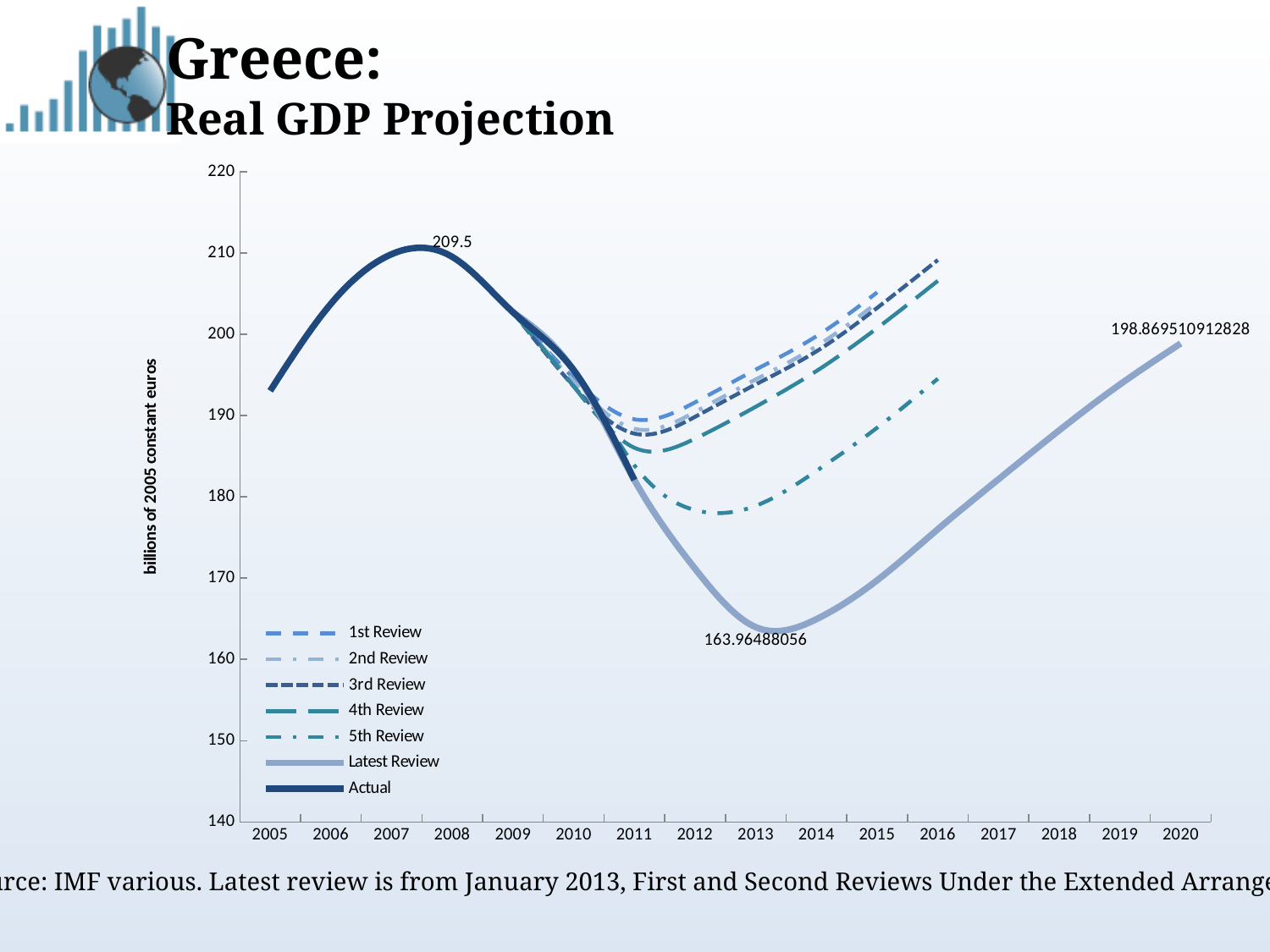
What is the peak value labelled on the Actual series? 209.5 What is the lowest value labelled on the Latest Review series? 163.96488056 Is the value of the Latest Review series in 2013 greater or less than 170? less Is the value of the Actual series in 2005 greater or less than 190? greater What value is labelled for the Latest Review series in 2020? 198.869510912828 Which series reaches the lowest value on the chart? Latest Review How many series does the legend list? 7 How many years are shown on the x axis? 16 What kind of chart is shown on the slide? line chart Is the value of the 5th Review series in 2016 greater or less than 190? greater What is the difference between the labelled peak of the Actual series (209.5) and the labelled low of the Latest Review series (163.96488056)? 45.53511944 In 2016, which series is higher: 3rd Review or 5th Review? 3rd Review